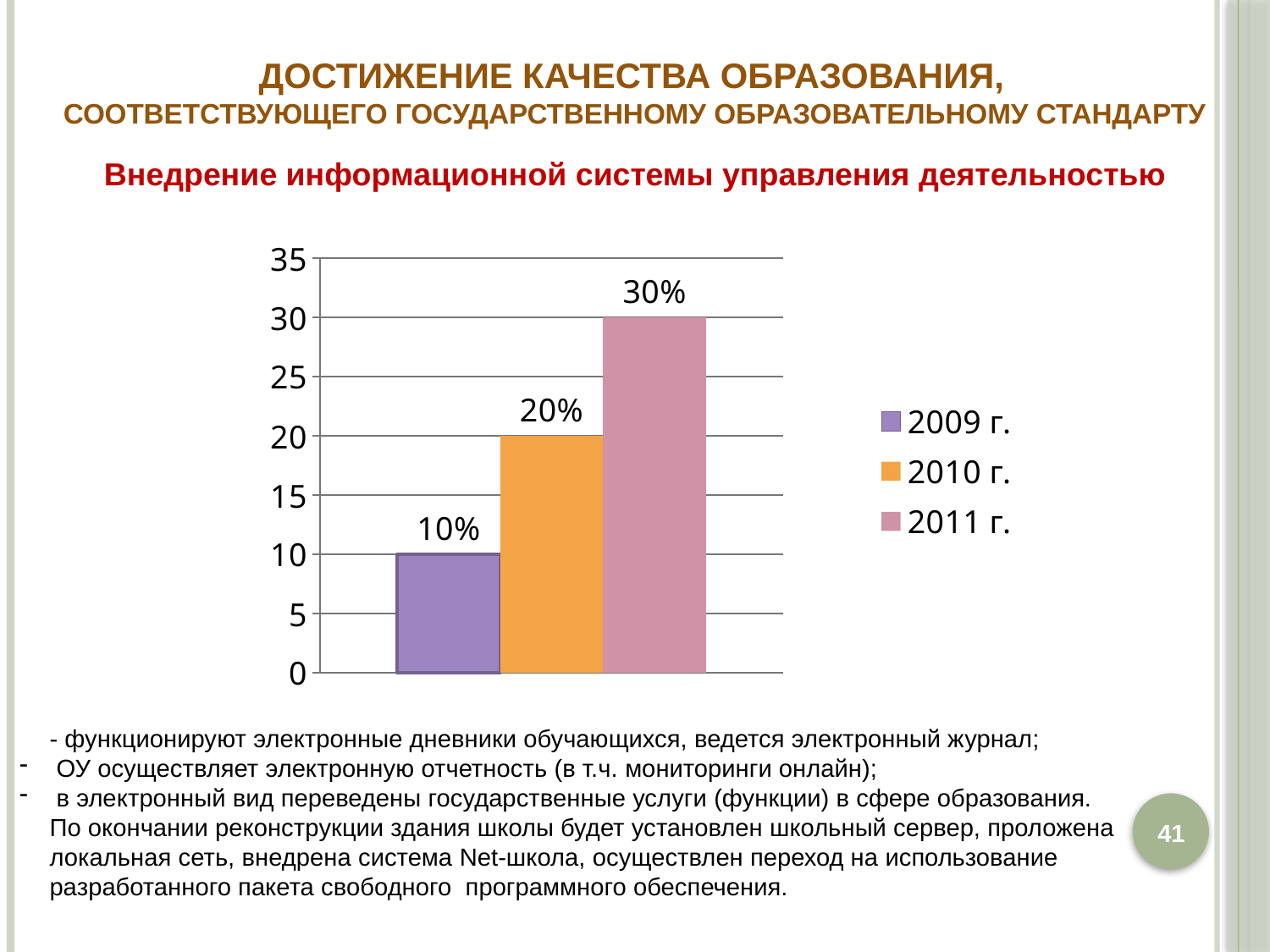
Do the values rise or fall from 2009 г. to 2011 г.? rise Which year has the lowest value? 2009 г. What is the difference between the values for 2010 г. and 2009 г.? 10% What kind of chart is shown on the slide? bar chart What is the value for 2009 г.? 10% What is the value for 2010 г.? 20% Which is larger, the value for 2010 г. or the value for 2011 г.? 2011 г. Which year has the highest value? 2011 г. Is the value for 2011 г. greater or less than 25? greater What is the value for 2011 г.? 30% How many series does the legend list? 3 What is the difference between the values for 2011 г. and 2009 г.? 20%